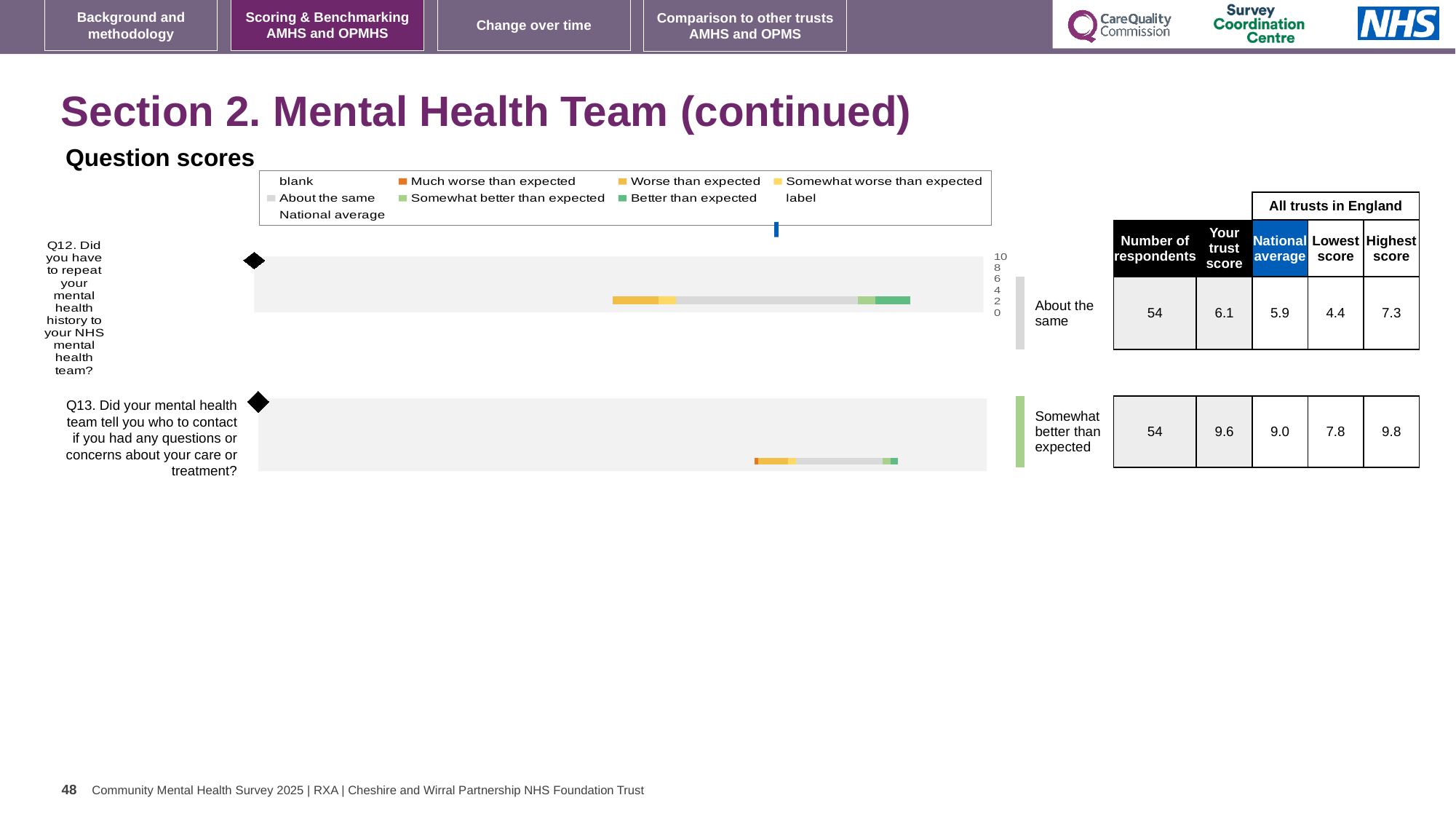
What kind of chart is used to show the question scores for Q12 and Q13? bar chart How many questions are charted on this slide? 2 In the legend, what colour represents 'Much worse than expected'? orange What is the 'Your trust score' for Q12 (repeating your mental health history)? 6.1 What is the 'Your trust score' for Q13 (being told who to contact)? 9.6 What is the difference between the highest score (7.3) and the lowest score (4.4) for Q12? 2.9 Which question has the higher trust score, Q12 or Q13? Q13 What is the difference between the trust score (9.6) and the national average (9.0) for Q13? 0.6 What benchmark category is shown next to the Q13 bar? Somewhat better than expected What is the highest score among all trusts in England for Q13? 9.8 How many respondents answered Q12? 54 What is the national average score for Q12? 5.9